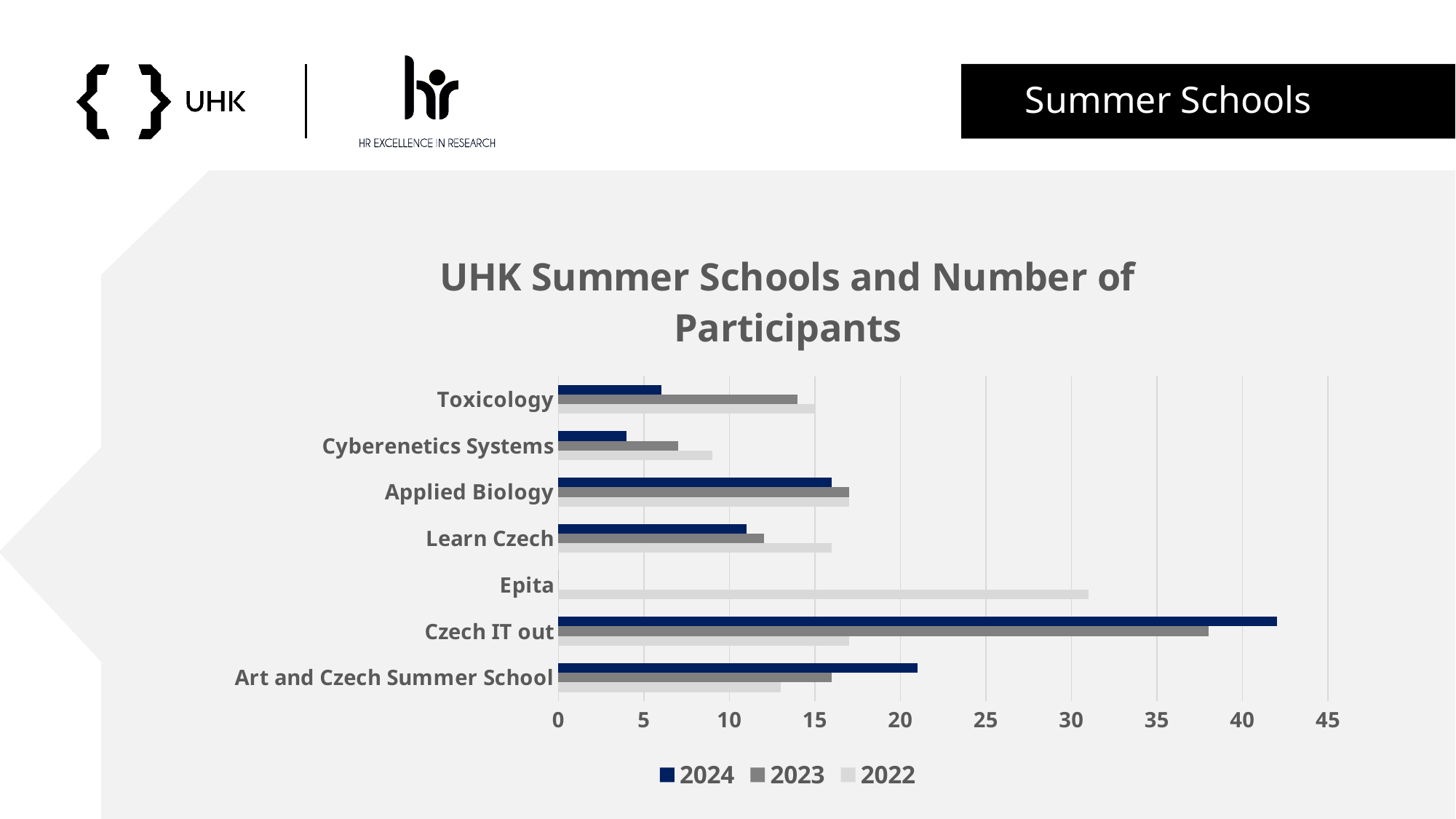
Is the 2024 value for Czech IT out greater or less than 40? greater How many summer schools (categories) are shown on the chart? 7 What is the title of the chart? UHK Summer Schools and Number of Participants What are the entries in the chart's legend? 2024, 2023, 2022 Which summer school has the highest number of participants in 2024? Czech IT out Which summer school has the highest number of participants in 2022? Epita For Art and Czech Summer School, which year has more participants, 2024 or 2023? 2024 Is the 2022 value for Epita greater or less than 30? greater For Toxicology, which year has more participants, 2024 or 2023? 2023 What kind of chart is shown on the slide? bar chart Is the 2024 value for Cyberenetics Systems greater or less than 5? less How many series does the legend list? 3